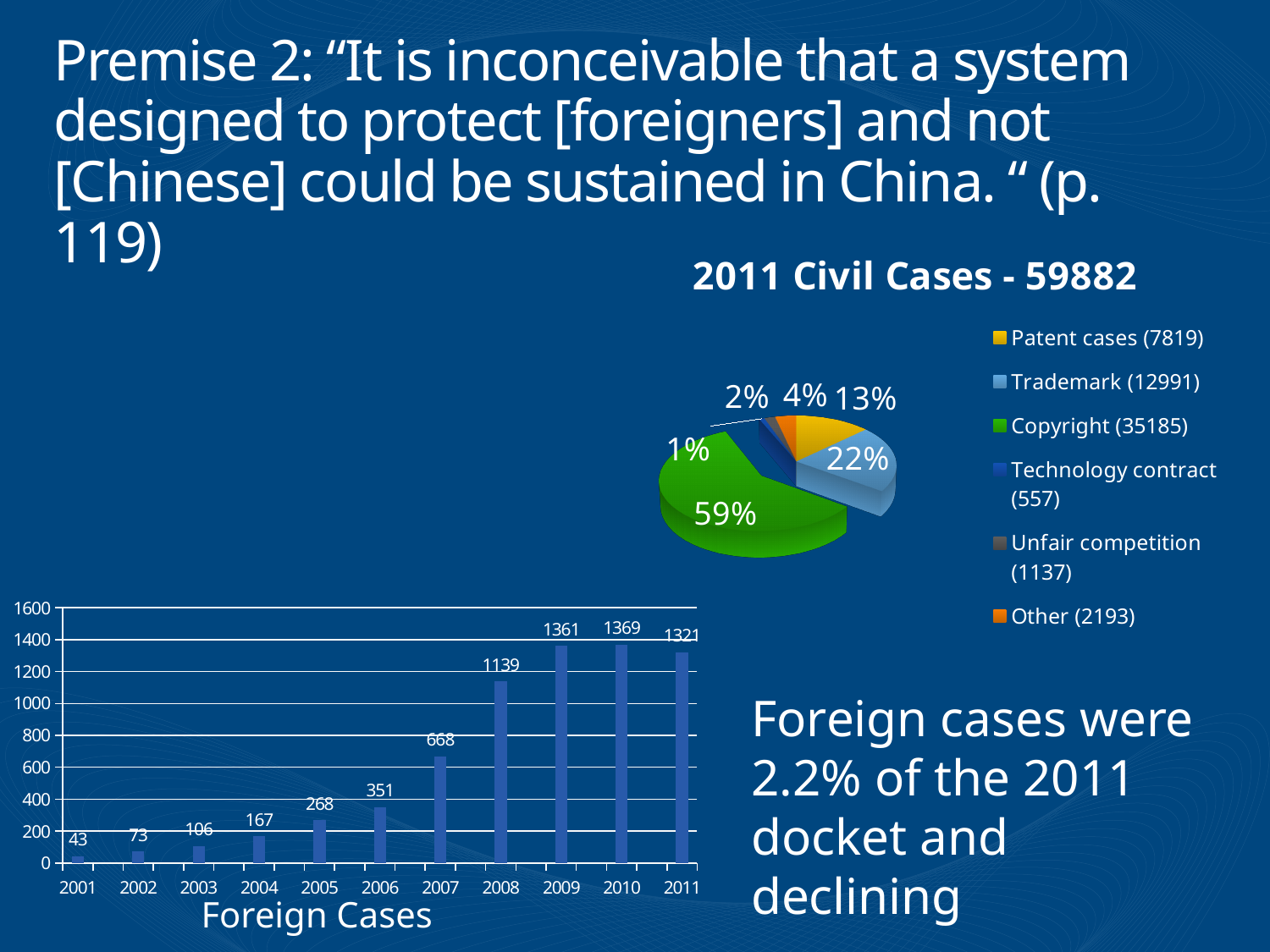
What kind of chart is the Foreign Cases chart? bar chart In the Foreign Cases bar chart, what is the value for 2008? 1139 In the 2011 Civil Cases pie chart, what share does Trademark have? 22% How many categories does the legend of the 2011 Civil Cases pie chart list? 6 In the Foreign Cases bar chart, which year has the lowest value? 2001 In the Foreign Cases bar chart, what is the value for 2004? 167 How many years are shown in the Foreign Cases bar chart? 11 In the Foreign Cases bar chart, do the values generally rise or fall from 2001 to 2010? rise In the Foreign Cases bar chart, which year has the highest value? 2010 In the Foreign Cases bar chart, what is the difference between the values for 2007 and 2006? 317 In the 2011 Civil Cases pie chart, what share does Copyright have? 59% In the Foreign Cases bar chart, which is larger, the value for 2009 or the value for 2011? 2009